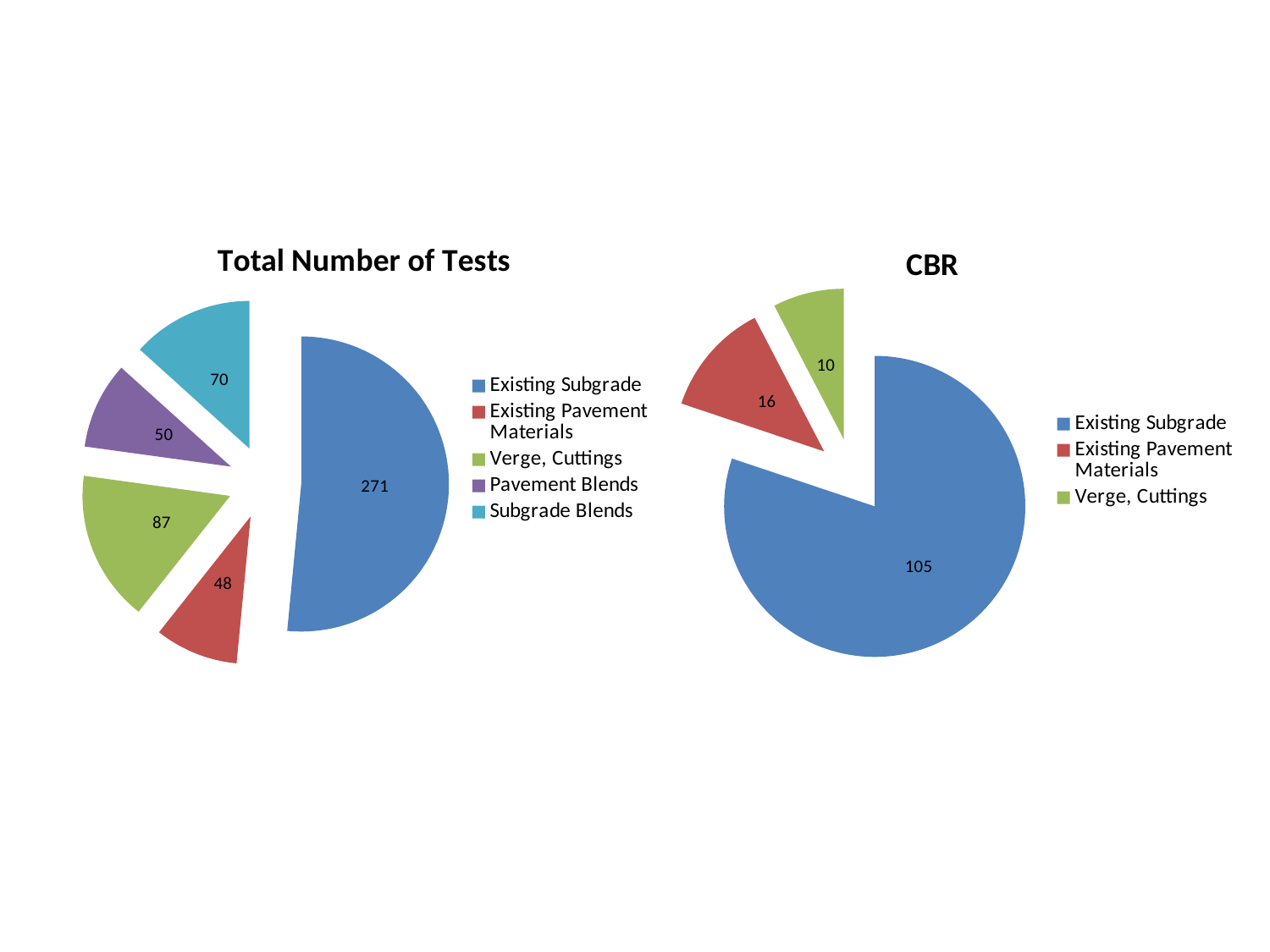
In the 'CBR' chart, what is the value for Existing Pavement Materials? 16 In the 'CBR' chart, how many categories does the legend list? 3 In the 'Total Number of Tests' chart, what is the value for Verge, Cuttings? 87 In the 'Total Number of Tests' chart, what is the value for Pavement Blends? 50 In the 'CBR' chart, which category has the largest value? Existing Subgrade What type of chart is the 'CBR' chart? Pie chart In the 'Total Number of Tests' chart, how many categories are shown? 5 In the 'Total Number of Tests' chart, what is the difference between Subgrade Blends and Existing Pavement Materials? 22 In the 'Total Number of Tests' chart, what is the total of all slices? 526 In the 'CBR' chart, which is larger: Existing Pavement Materials or Verge, Cuttings? Existing Pavement Materials In the 'Total Number of Tests' chart, what is the value for Existing Subgrade? 271 In the 'Total Number of Tests' chart, which category has the smallest value? Existing Pavement Materials